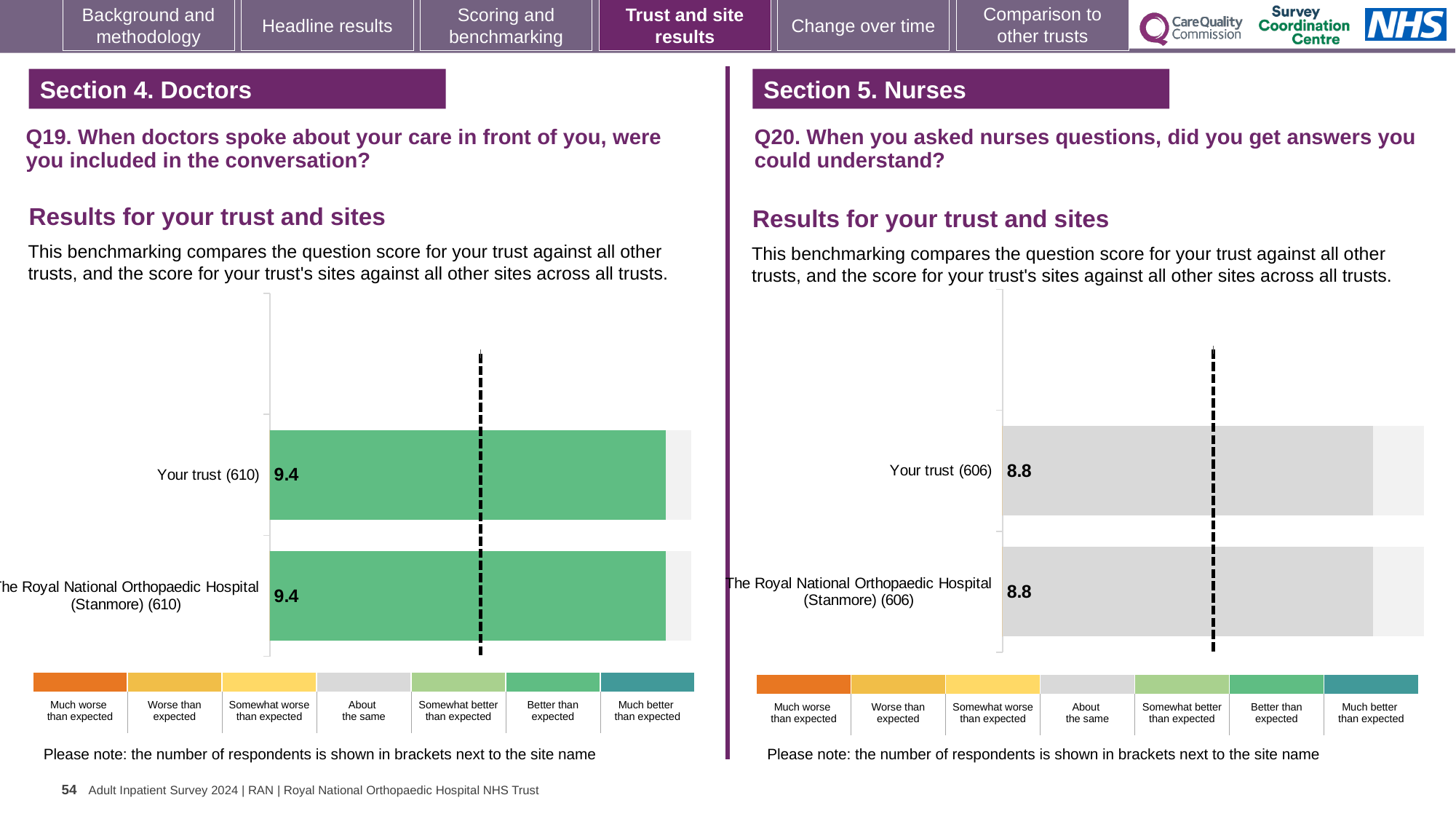
On the Q20 chart (right), what is the score for Your trust? 8.8 On the Q20 chart (right), what is the score for The Royal National Orthopaedic Hospital (Stanmore)? 8.8 On the Q19 chart (left), what is the difference between the score for Your trust and the score for The Royal National Orthopaedic Hospital (Stanmore)? 0 On the Q19 chart (left), what is the score for The Royal National Orthopaedic Hospital (Stanmore)? 9.4 On the Q20 chart (right), what is the difference between the score for Your trust and the score for The Royal National Orthopaedic Hospital (Stanmore)? 0 On the Q20 chart (right), which benchmark category does the colour of the bars correspond to in the legend? About the same Is the score for Your trust on the Q19 chart (left) larger or smaller than the score for Your trust on the Q20 chart (right)? Larger How many bars are plotted on the Q19 chart (left)? 2 On the Q19 chart (left), how many respondents are shown in brackets for Your trust? 610 How many bars are plotted on the Q20 chart (right)? 2 On the Q19 chart (left), what is the score for Your trust? 9.4 What kind of chart is used on the Q19 chart (left)? Bar chart